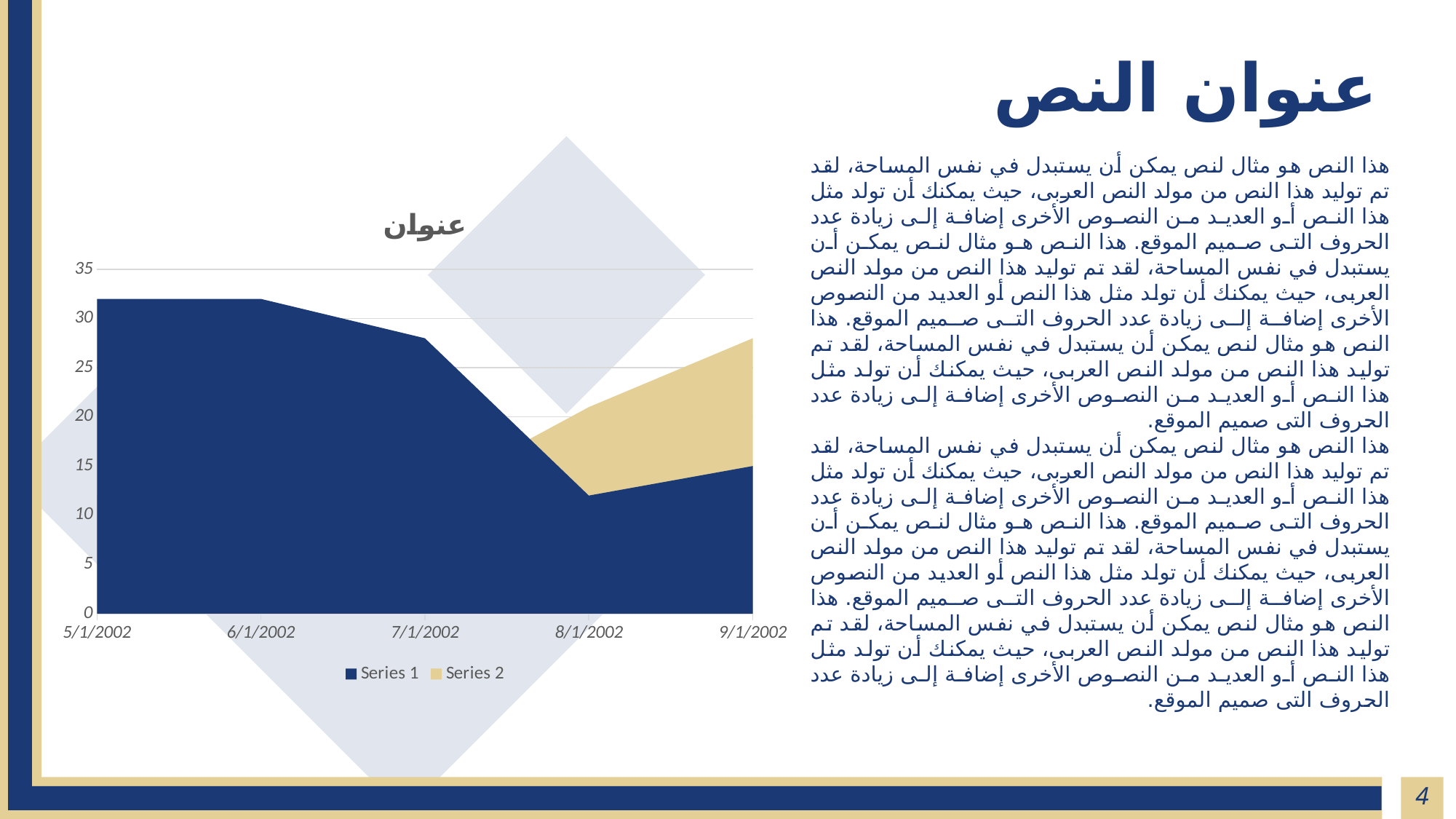
Does Series 1 rise or fall from 6/1/2002 to 8/1/2002? fall At which date does Series 1 reach its lowest value? 8/1/2002 How many series does the chart legend list? 2 Is the value of Series 1 at 5/1/2002 greater or less than 30? greater Is the value of Series 1 at 9/1/2002 greater or less than 20? less Is the value of Series 1 at 7/1/2002 greater or less than 25? greater How many dates are shown along the x axis of the chart? 5 What kind of chart is shown on the slide? area chart Which is larger for Series 1: the value at 7/1/2002 or the value at 8/1/2002? 7/1/2002 What is the title of the chart? عنوان What colour is Series 1 in the chart? dark blue